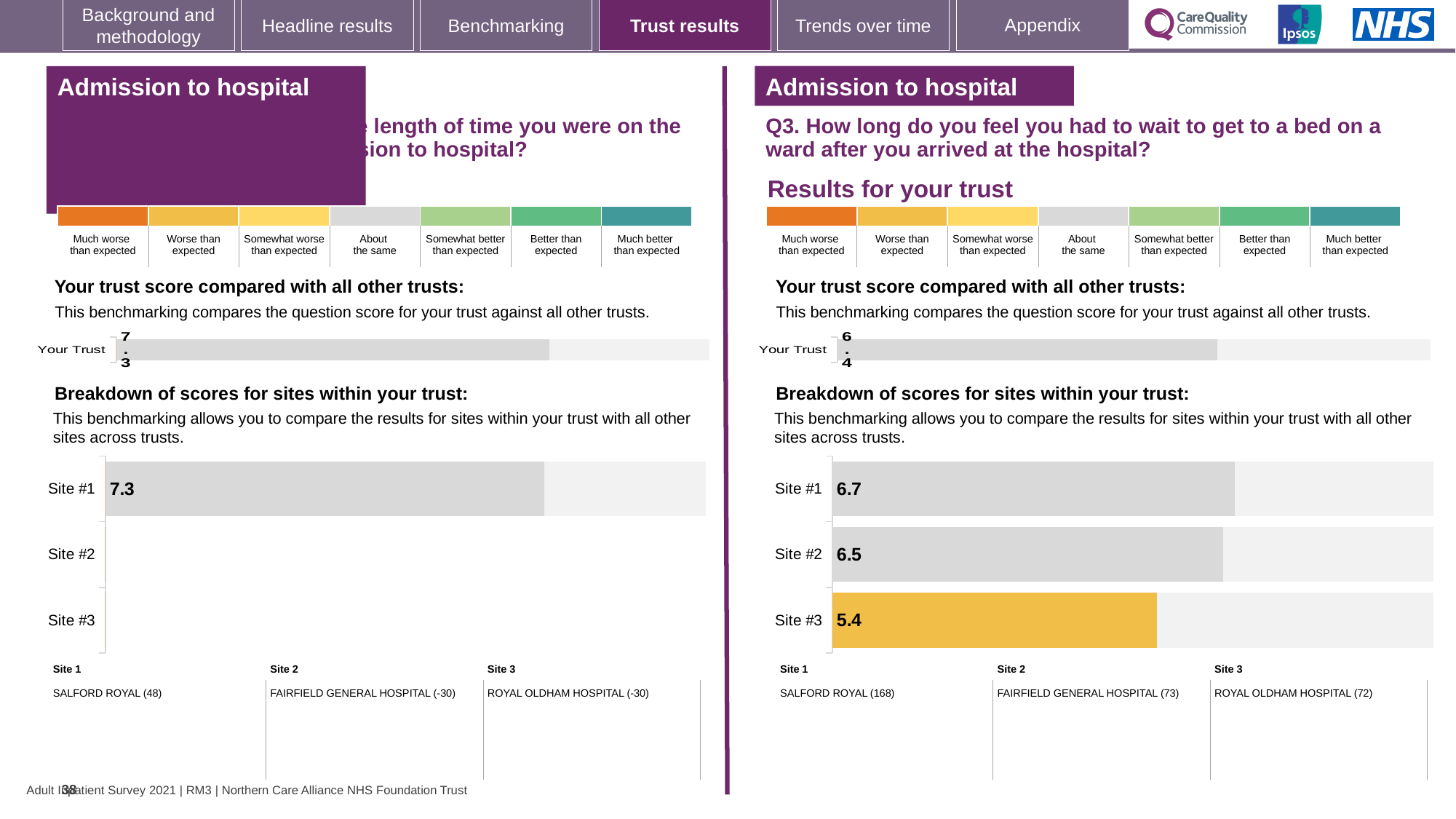
On the right-hand site breakdown chart for Q3, which site has the highest score? Site #1 On the left-hand site breakdown chart, what is the score for Site #1? 7.3 On the right-hand site breakdown chart for Q3, which site has the lowest score? Site #3 On the right-hand chart for Q3 (wait to get to a bed on a ward), what is the score for Site #3? 5.4 On the right-hand 'Your trust score compared with all other trusts' chart for Q3, what is the score shown for Your Trust? 6.4 On the right-hand site breakdown chart for Q3, which is larger, the score for Site #2 or Site #3? Site #2 On the right-hand site breakdown chart for Q3, which site's bar is coloured yellow rather than grey? Site #3 What type of chart is used for the site breakdown on the right-hand side of the slide? Bar chart On the left-hand 'Your trust score compared with all other trusts' chart, what is the score shown for Your Trust? 7.3 On the right-hand chart for Q3 (wait to get to a bed on a ward), what is the score for Site #2? 6.5 On the right-hand chart for Q3 (wait to get to a bed on a ward), what is the score for Site #1? 6.7 On the right-hand site breakdown chart for Q3, what is the difference between the scores for Site #1 and Site #3? 1.3